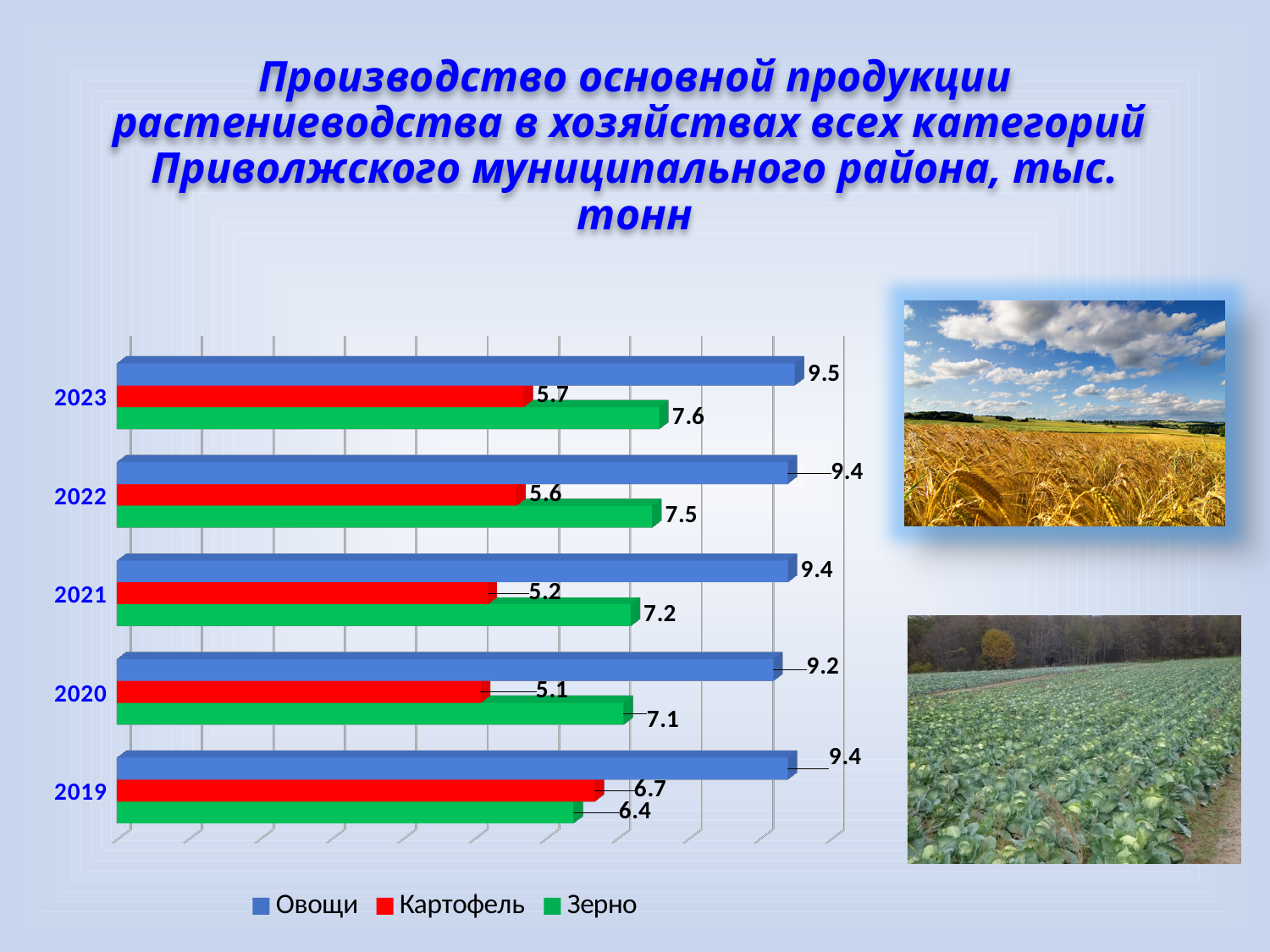
Which is larger in 2019: Картофель or Зерно? Картофель How many series does the legend list? 3 What kind of chart is shown on the slide? Bar chart What is the value for Овощи in 2023? 9.5 In which year is the value for Овощи the highest? 2023 In which year is the value for Зерно the lowest? 2019 What is the difference between the Зерно values for 2023 and 2019? 1.2 What is the value for Зерно in 2021? 7.2 In which year is the value for Картофель the lowest? 2020 Which colour represents Зерно in the legend? Green What is the value for Картофель in 2019? 6.7 How many years are shown on the chart? 5